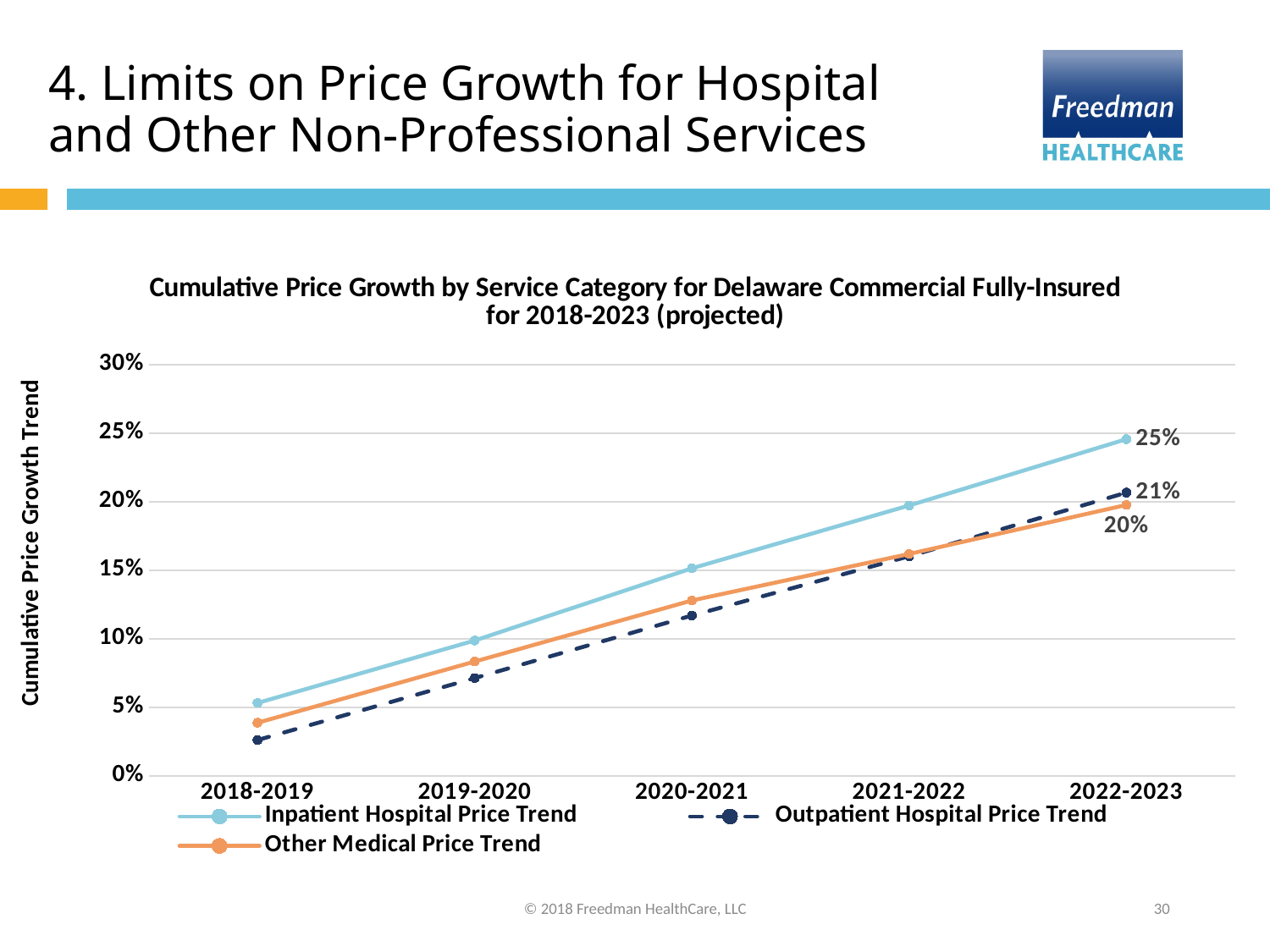
What is the difference between the Inpatient Hospital Price Trend and the Other Medical Price Trend in 2022-2023? 5 percentage points How many series does the legend list? 3 Is the value for the Inpatient Hospital Price Trend in 2018-2019 greater or less than 10%? less How many time periods are shown on the x axis? 5 What is the value for the Inpatient Hospital Price Trend in 2022-2023? 25% Which series has the lowest value in 2022-2023? Other Medical Price Trend Does the Outpatient Hospital Price Trend rise or fall from 2018-2019 to 2022-2023? Rises What is the value for the Other Medical Price Trend in 2022-2023? 20% Is the value for the Inpatient Hospital Price Trend in 2021-2022 greater or less than 15%? greater What is the value for the Outpatient Hospital Price Trend in 2022-2023? 21% What kind of chart is shown on the slide? Line chart Which series has the highest value in 2022-2023? Inpatient Hospital Price Trend